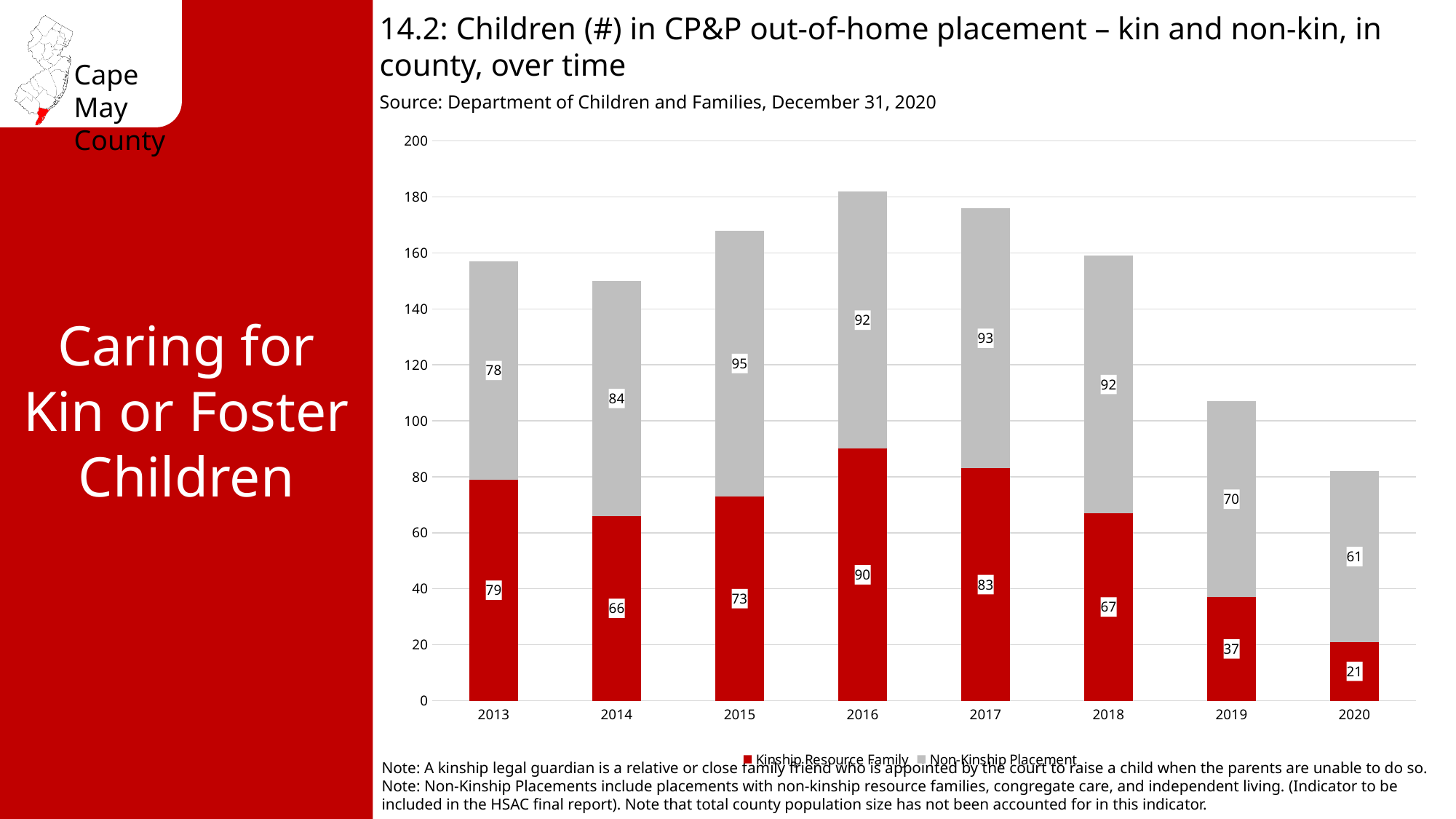
What kind of chart is shown? Stacked bar chart Which year has the lowest Kinship Resource Family value? 2020 How many series does the legend list? 2 What is the Kinship Resource Family value for 2016? 90 What is the Kinship Resource Family value for 2020? 21 Which year has the highest Non-Kinship Placement value? 2015 Which is larger, the Kinship Resource Family value for 2017 or for 2018? 2017 What is the total of the stacked bar for 2016? 182 What is the total of the stacked bar for 2020? 82 What is the Non-Kinship Placement value for 2015? 95 How many years are shown on the x axis? 8 What is the difference between the Non-Kinship Placement values for 2018 and 2019? 22